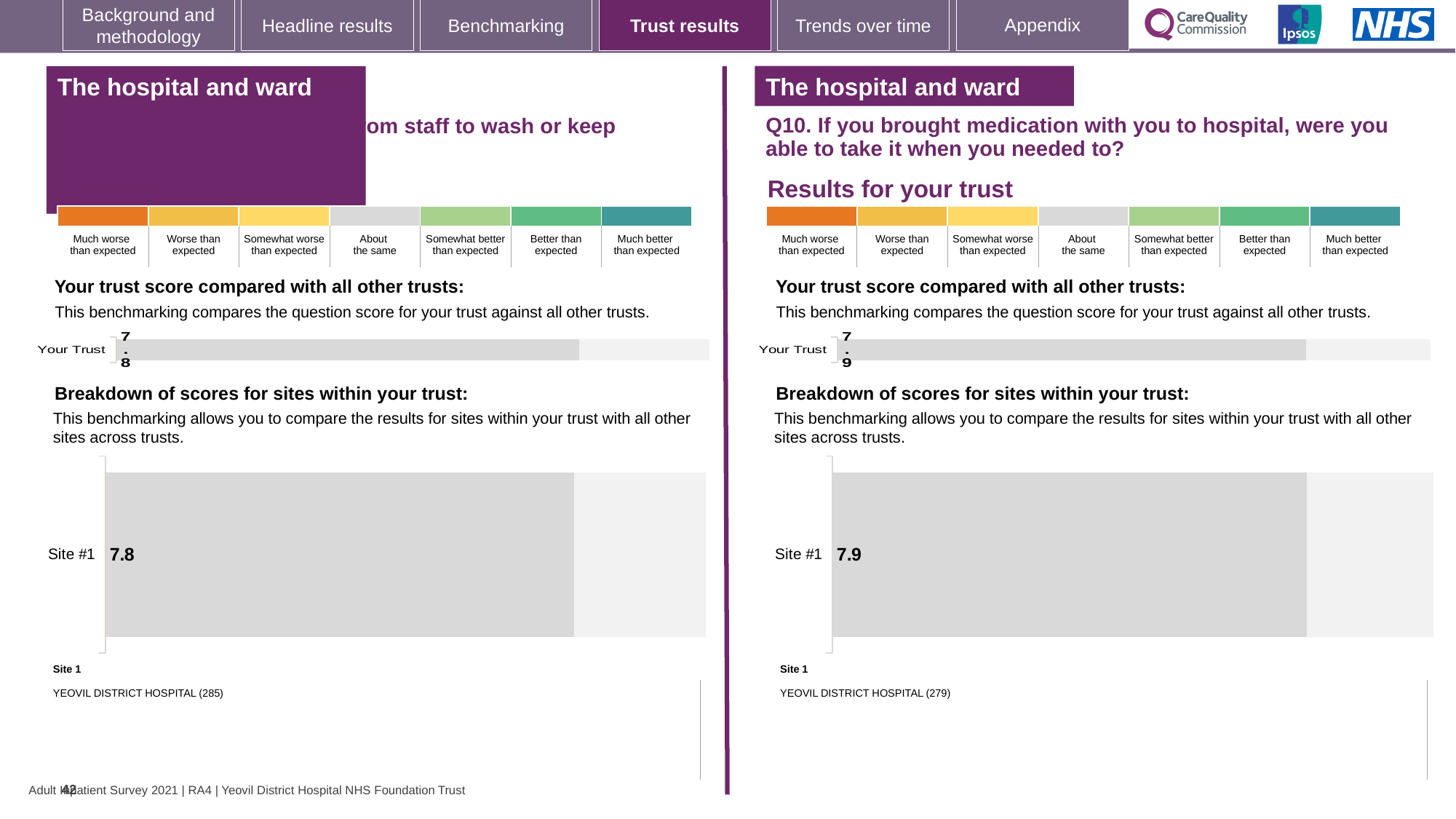
On the left-hand chart (staff to wash or keep clean question), what is the score shown for Your Trust? 7.8 What type of chart is used to show the Site #1 score on the right-hand side for Q10? Bar chart What is the difference between the Site #1 score on the right-hand chart for Q10 and the Site #1 score on the left-hand chart? 0.1 How many sites are shown in the site breakdown chart on the right-hand side for Q10? 1 Which is larger: the Site #1 score on the left-hand chart or the Site #1 score on the right-hand chart for Q10? Right-hand chart (Q10) On the right-hand side for Q10, which site is listed as Site 1? YEOVIL DISTRICT HOSPITAL (279) On the right-hand chart for Q10 (medication), what is the score shown for Your Trust? 7.9 On the right-hand chart for Q10 (medication), what is the score shown for Site #1? 7.9 On the left-hand side, which site is listed as Site 1? YEOVIL DISTRICT HOSPITAL (285) How many sites are shown in the site breakdown chart on the left-hand side? 1 On the left-hand chart (staff to wash or keep clean question), what is the score shown for Site #1? 7.8